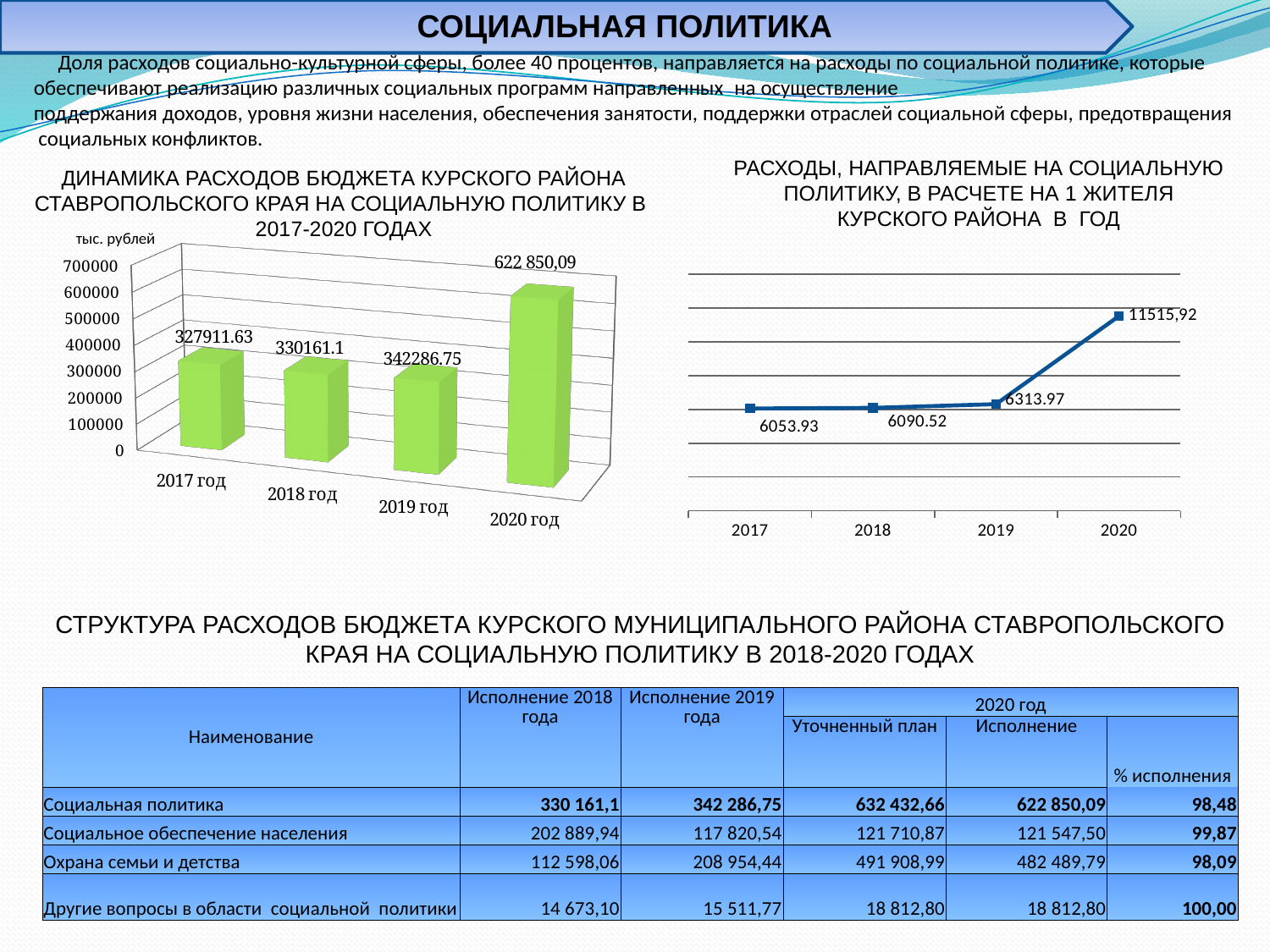
In the right chart (expenditures on social policy per 1 resident per year), do the values rise or fall from 2017 to 2020? rise In the right chart (expenditures on social policy per 1 resident per year), what is the value for 2018? 6090.52 What type of chart is the left chart (dynamics of social policy expenditures 2017-2020)? bar chart In the right chart (expenditures on social policy per 1 resident per year), what is the difference between the values for 2019 and 2018? 223.45 In the left chart (dynamics of social policy expenditures 2017-2020), which year has the highest value? 2020 год In the right chart (expenditures on social policy per 1 resident per year), what is the value for 2020? 11515,92 In the left chart (dynamics of social policy expenditures 2017-2020), what is the difference between the values for 2019 год and 2018 год? 12125.65 In the left chart (dynamics of social policy expenditures 2017-2020), which year has the lowest value? 2017 год In the left chart (dynamics of social policy expenditures 2017-2020), is the value for 2020 год greater or less than 600000? greater In the left chart (dynamics of social policy expenditures 2017-2020), what is the value for 2020 год? 622 850,09 How many data points are plotted in the right chart (expenditures on social policy per 1 resident per year)? 4 In the left chart (dynamics of social policy expenditures 2017-2020), what is the value for 2017 год? 327911.63